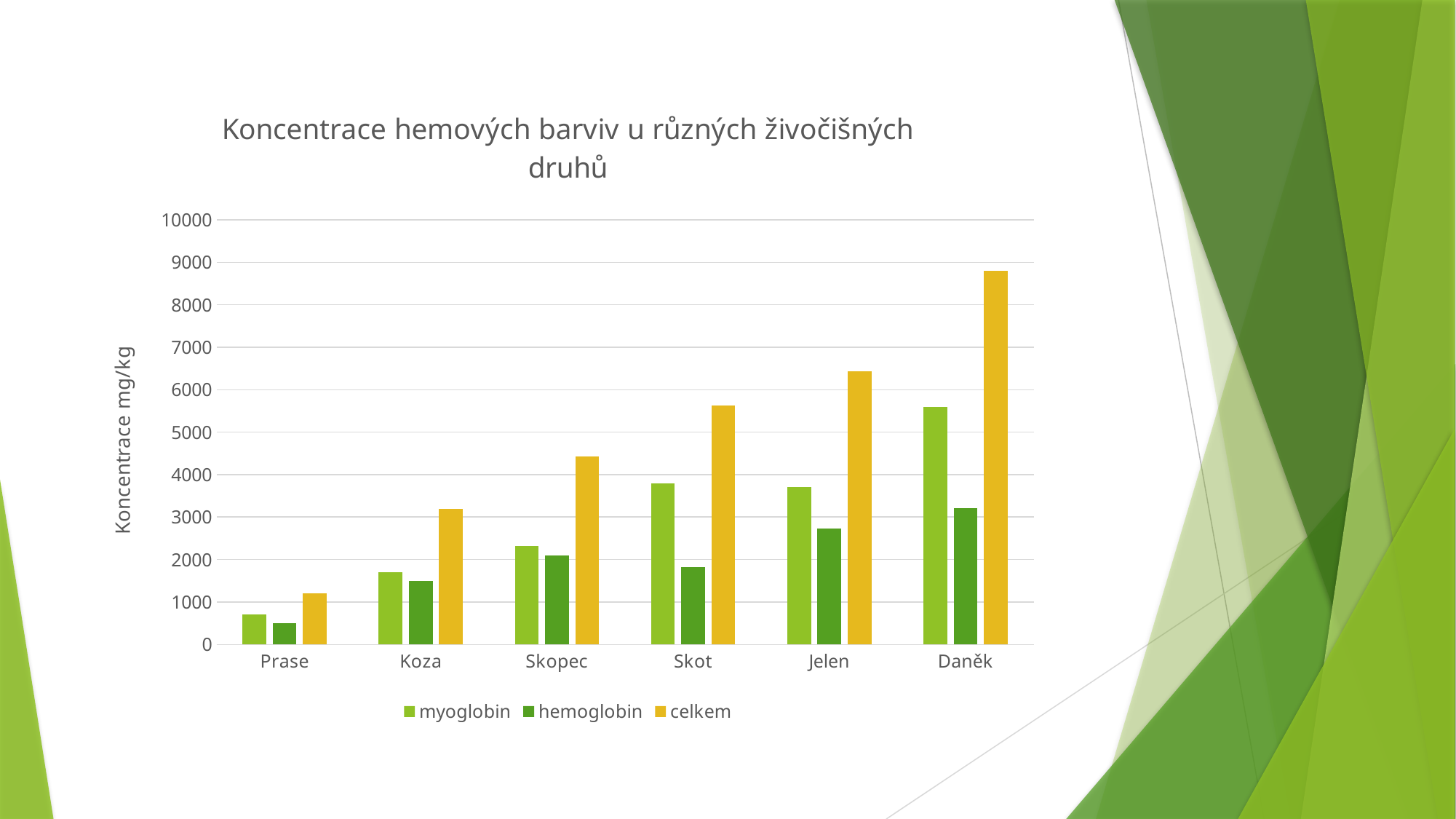
Is the celkem value for Daněk greater or less than 8000? greater Is the celkem value for Skot greater or less than 5000? greater Is the hemoglobin value for Jelen greater or less than 2000? greater What kind of chart is shown on the slide? bar chart Which category has the highest celkem value? Daněk Which category has the lowest celkem value? Prase How many animal species (categories) are shown on the x axis? 6 Do the celkem values rise or fall moving from Prase to Daněk along the x axis? rise For Daněk, which is larger: the myoglobin value or the hemoglobin value? myoglobin How many series does the legend list? 3 What is the label of the vertical axis? Koncentrace mg/kg